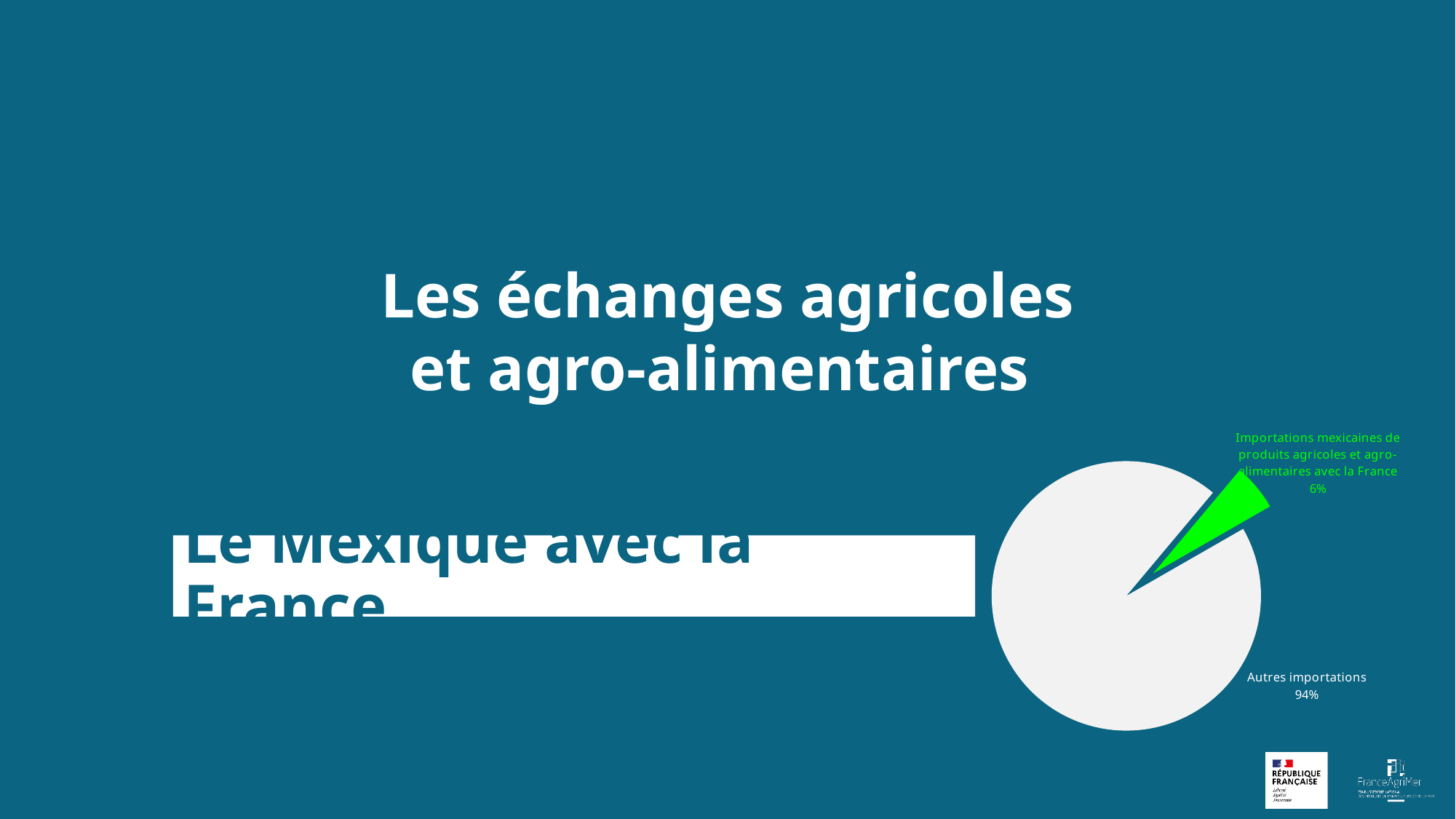
What share of the pie is labelled "Importations mexicaines de produits agricoles et agro-alimentaires avec la France"? 6% What kind of chart is shown on the slide? pie chart Is the share for "Importations mexicaines de produits agricoles et agro-alimentaires avec la France" greater or less than 10%? less Is the share for "Autres importations" greater or less than 50%? greater What share of the pie is labelled "Autres importations"? 94% Which slice of the pie chart is the smallest? Importations mexicaines de produits agricoles et agro-alimentaires avec la France What colour is the slice for "Importations mexicaines de produits agricoles et agro-alimentaires avec la France"? green Which is larger: the "Autres importations" slice or the "Importations mexicaines de produits agricoles et agro-alimentaires avec la France" slice? Autres importations Which slice of the pie chart is the largest? Autres importations What colour is the "Autres importations" slice of the pie chart? light grey How many slices does the pie chart have? 2 What is the difference in percentage points between the "Autres importations" slice and the "Importations mexicaines de produits agricoles et agro-alimentaires avec la France" slice? 88 percentage points